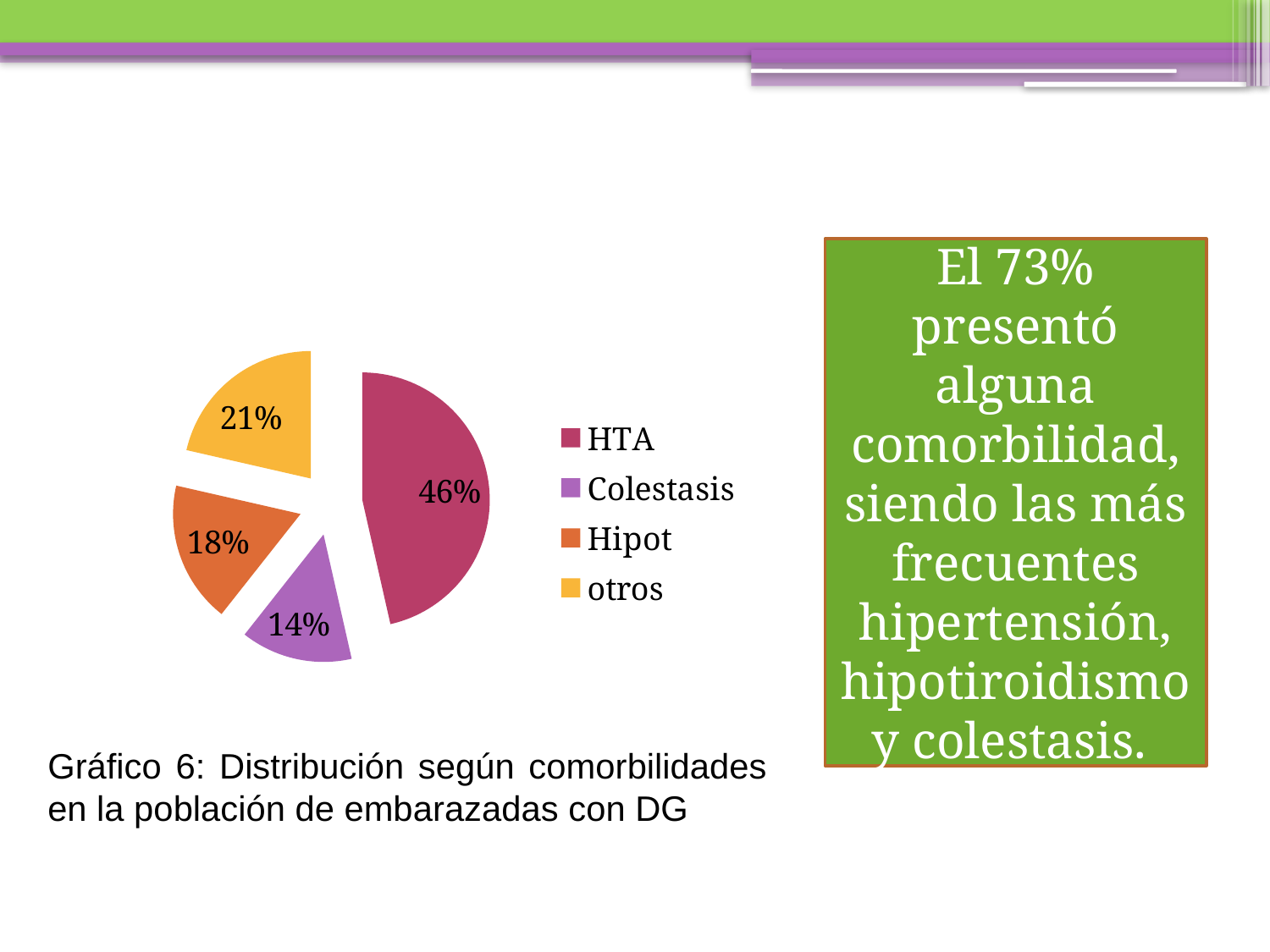
What colour is the slice for otros in the pie chart? Yellow What percentage of the pie chart corresponds to Colestasis? 14% What is the difference in percentage points between HTA and otros? 25 Which is larger, the slice for Hipot or the slice for Colestasis? Hipot Which category has the largest slice of the pie chart? HTA What type of chart is shown on the slide? Pie chart What percentage of the pie chart corresponds to HTA? 46% Which category has the smallest slice of the pie chart? Colestasis How many categories does the pie chart show? 4 What is the caption of the chart on the slide? Gráfico 6: Distribución según comorbilidades en la población de embarazadas con DG What percentage of the pie chart corresponds to Hipot? 18% What percentage of the pie chart corresponds to otros? 21%